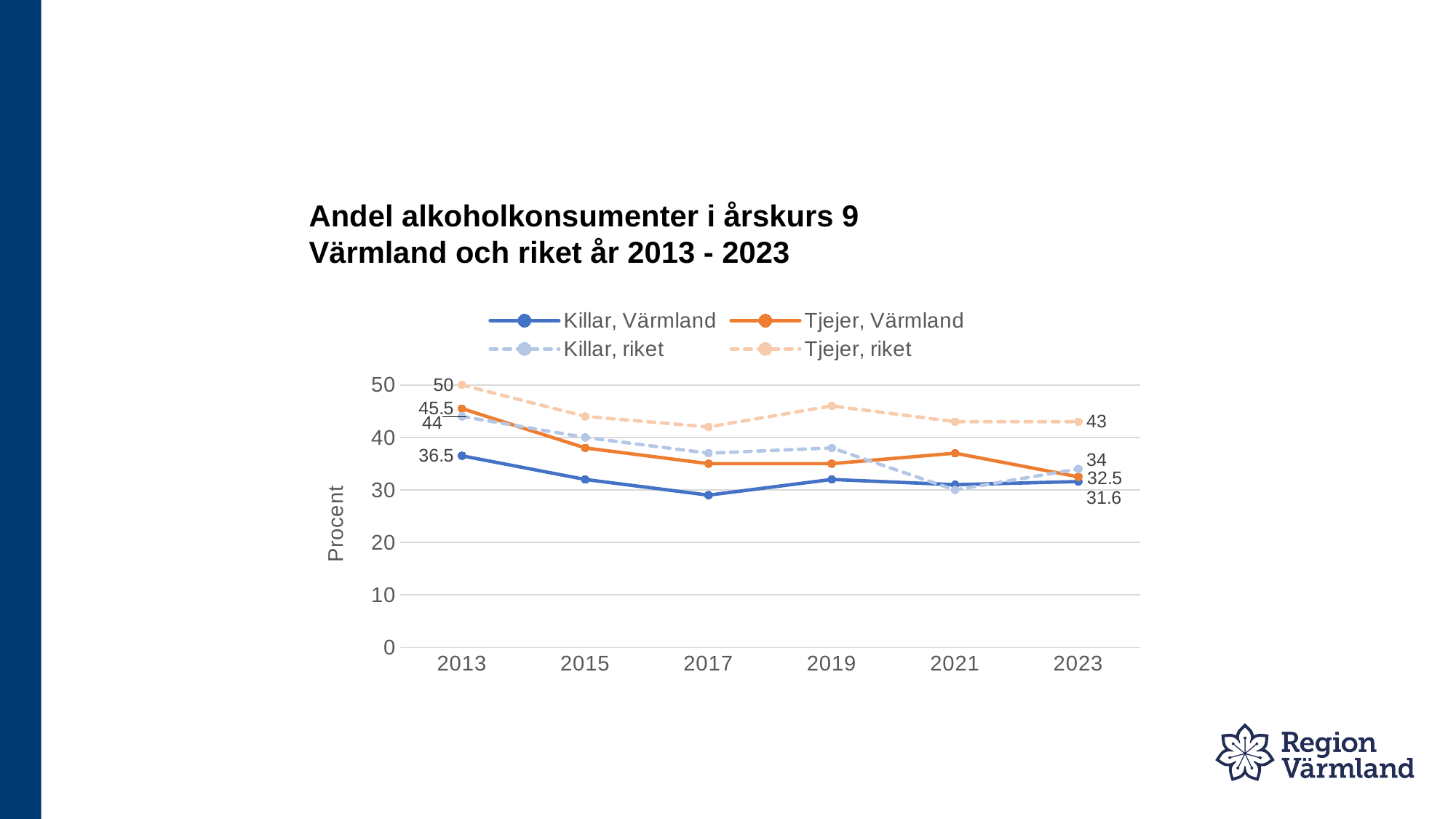
Which series has the highest value in 2013? Tjejer, riket How many series does the legend list? 4 How many years are shown on the x axis? 6 What is the value for Tjejer, riket in 2013? 50 What is the value for Killar, riket in 2023? 34 By how much did the value for Tjejer, riket fall from 2013 to 2023? 7 Which series has the lowest value in 2023? Killar, Värmland What kind of chart is shown on the slide? line chart What is the value for Killar, Värmland in 2013? 36.5 What is the value for Tjejer, Värmland in 2023? 32.5 What is the difference between the Killar, Värmland values in 2013 and 2023? 4.9 Is the value for Killar, Värmland in 2017 greater or less than 30? less